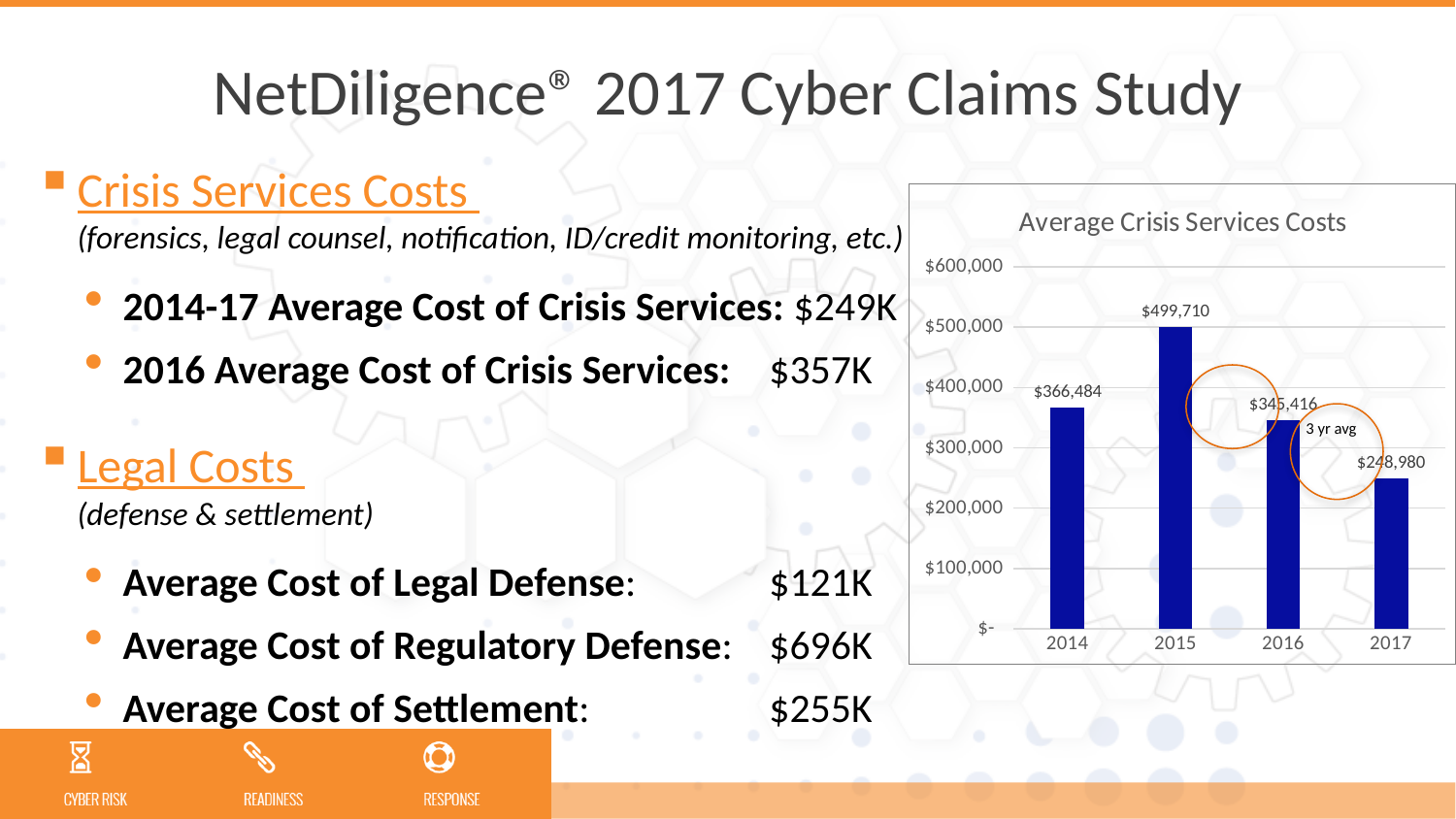
Which year has the highest average crisis services cost in the chart? 2015 What is the value for 2015 in the Average Crisis Services Costs chart? $499,710 What kind of chart is the Average Crisis Services Costs chart? bar chart In the Average Crisis Services Costs chart, do the values rise or fall from 2015 to 2017? fall How many years are plotted in the Average Crisis Services Costs chart? 4 What is the difference between the 2015 and 2014 values in the Average Crisis Services Costs chart? $133,226 What is the value for 2014 in the Average Crisis Services Costs chart? $366,484 What is the value for 2017 in the Average Crisis Services Costs chart? $248,980 Which year has the lowest average crisis services cost in the chart? 2017 What is the difference between the 2016 and 2017 values in the Average Crisis Services Costs chart? $96,436 In the Average Crisis Services Costs chart, which is larger, the value for 2014 or the value for 2016? 2014 Is the value for 2017 in the Average Crisis Services Costs chart greater or less than $300,000? less